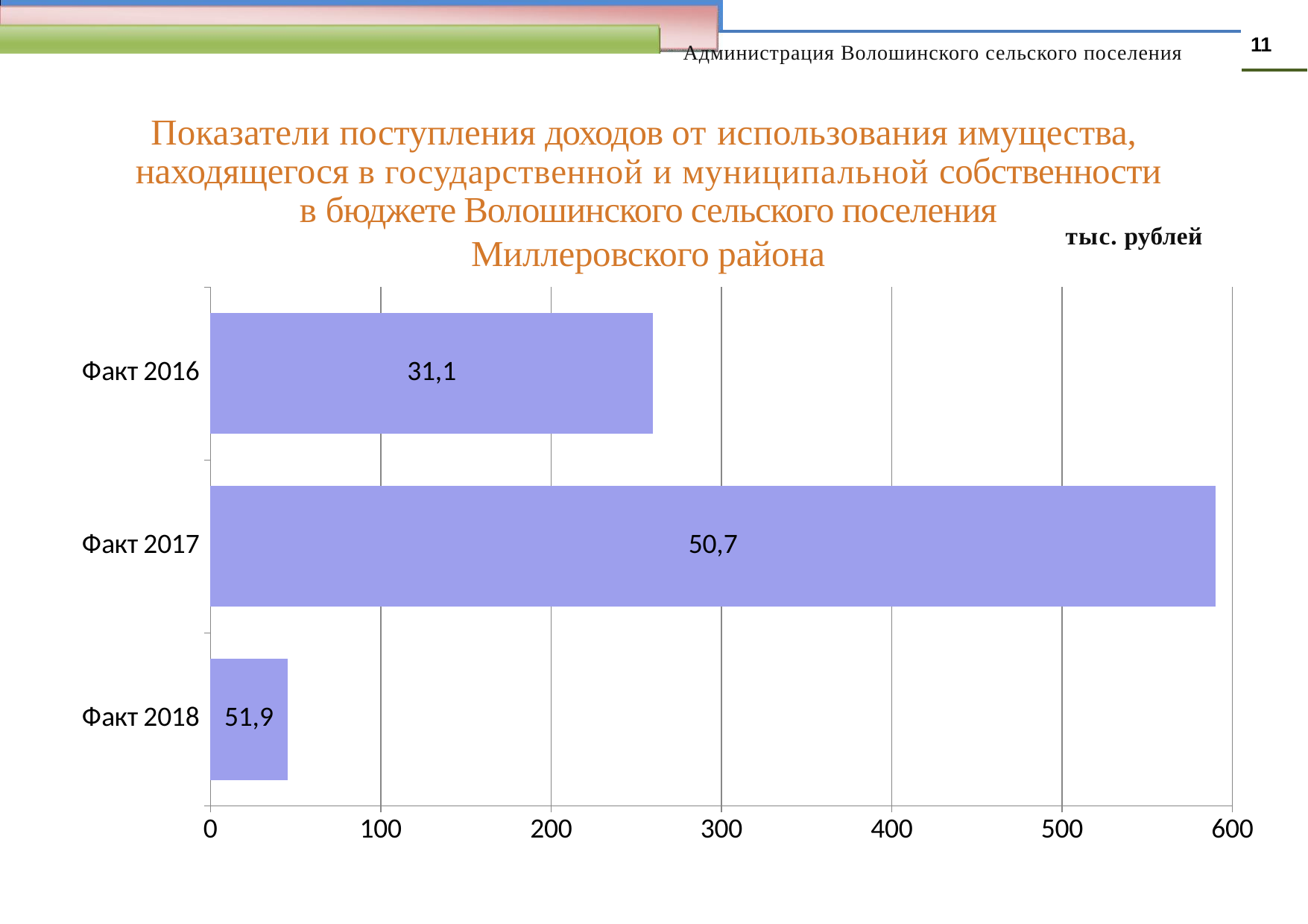
What is the data label shown for Факт 2016? 31,1 What unit of measurement is indicated above the chart? тыс. рублей What is the data label shown for Факт 2017? 50,7 What kind of chart is shown on the slide? Bar chart What is the data label shown for Факт 2018? 51,9 What is the difference between the labelled values for Факт 2018 and Факт 2016? 20,8 How many categories are plotted on the chart? 3 What is the difference between the labelled values for Факт 2018 and Факт 2017? 1,2 By how much does the labelled value for Факт 2017 exceed the labelled value for Факт 2016? 19,6 What is the highest value shown on the horizontal axis? 600